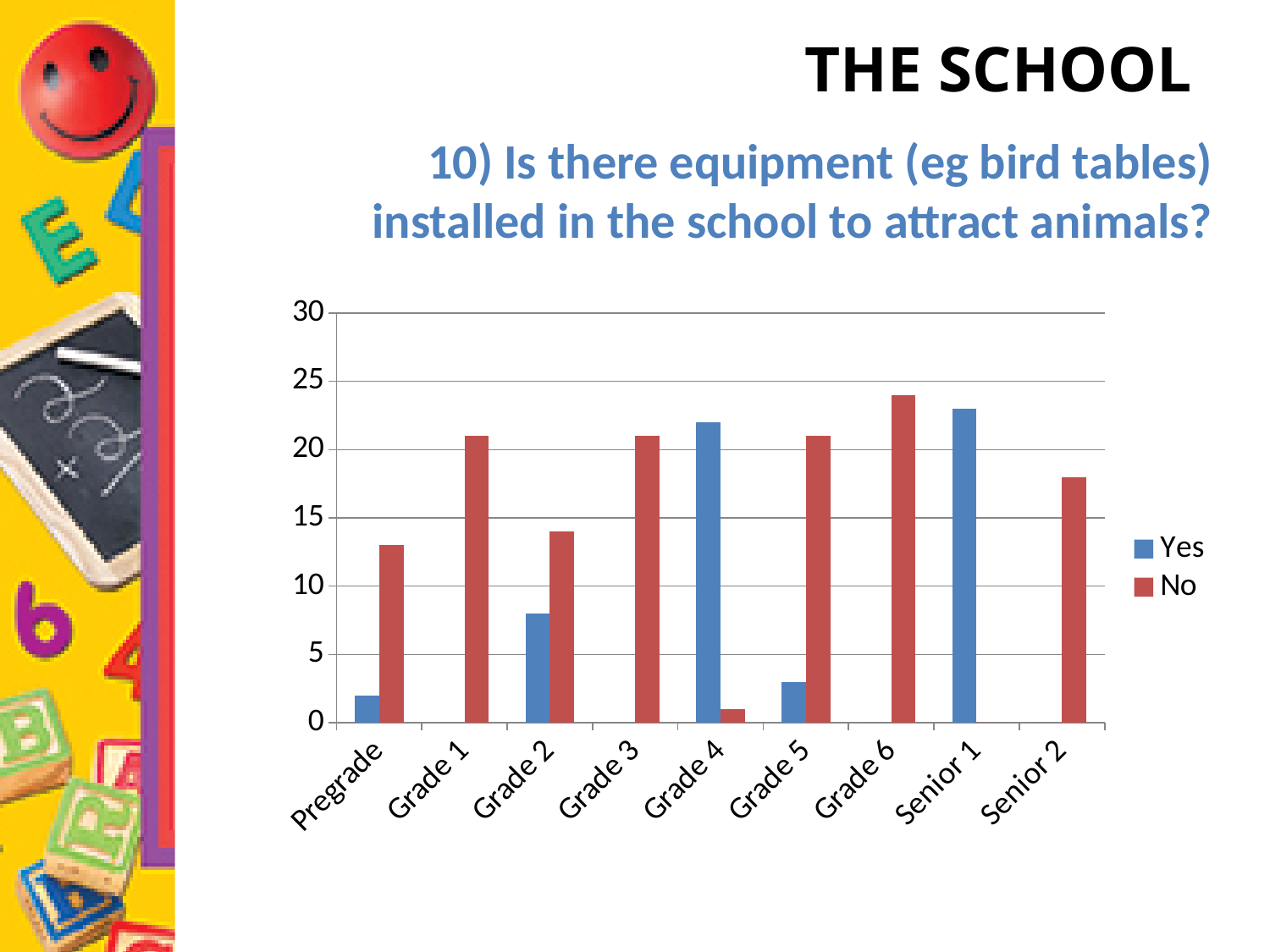
At Grade 2, which is larger, Yes or No? No Which colour represents the No series in the legend? red Is the value for No at Grade 6 greater or less than 20? greater How many categories are shown on the x axis? 9 Is the value for Yes at Grade 4 greater or less than 20? greater Which category has the highest value for the No series? Grade 6 Is the value for No at Senior 2 greater or less than 20? less At Grade 4, which is larger, Yes or No? Yes What kind of chart is shown on the slide? bar chart How many series does the legend list? 2